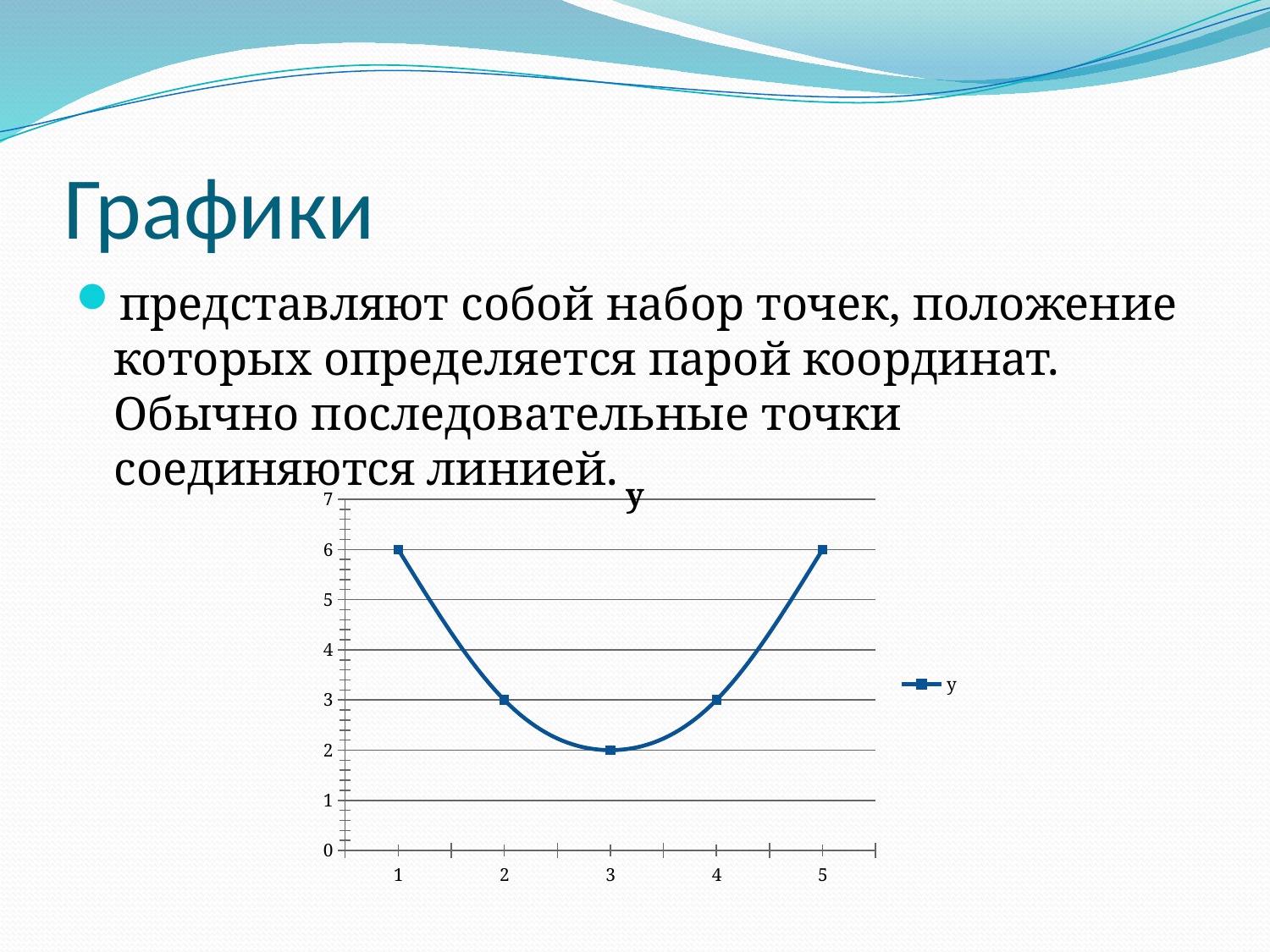
What is the value of y at x = 1? 6 Is the value of y at x = 5 greater or less than 4? greater How many series does the legend list? 1 At which x value is y lowest? 3 What is the title of the chart? y How many data points are plotted on the chart? 5 What kind of chart is shown on the slide? line chart What is the difference between the value of y at x = 1 and at x = 3? 4 What is the value of y at x = 3? 2 Which is larger, the value of y at x = 2 or at x = 5? x = 5 Do the values of y rise or fall from x = 1 to x = 3? fall What is the value of y at x = 4? 3